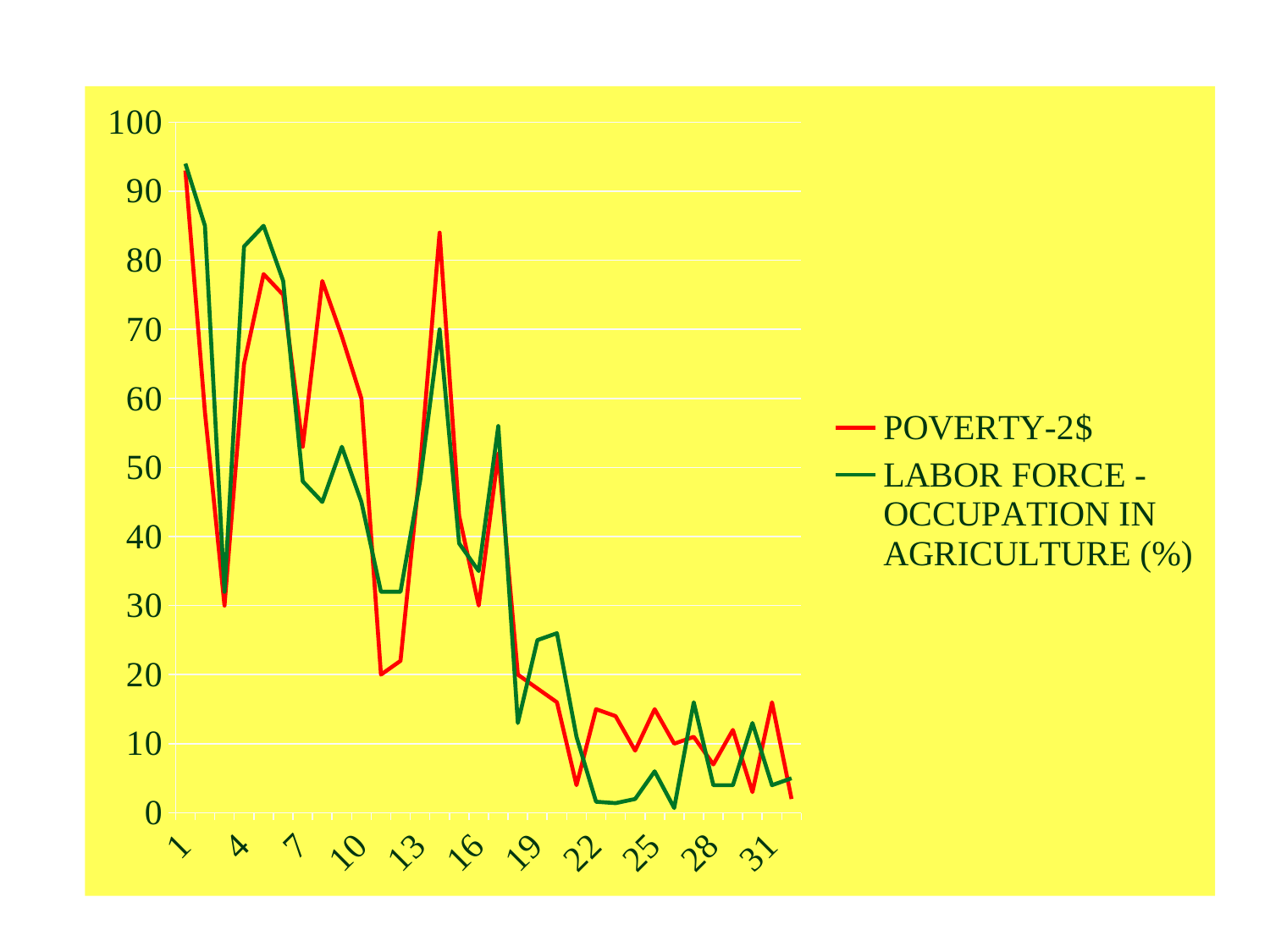
At category 14, which series has the larger value, POVERTY-2$ or LABOR FORCE - OCCUPATION IN AGRICULTURE (%)? POVERTY-2$ Is the value of POVERTY-2$ at category 14 greater or less than 80? greater Is the value of LABOR FORCE - OCCUPATION IN AGRICULTURE (%) at category 22 greater or less than 10? less At category 4, which series has the larger value, POVERTY-2$ or LABOR FORCE - OCCUPATION IN AGRICULTURE (%)? LABOR FORCE - OCCUPATION IN AGRICULTURE (%) How many series does the legend list? 2 What kind of chart is shown on the slide? line chart Overall, do the values of the POVERTY-2$ series rise or fall from left to right along the x axis? fall Which series is drawn in red? POVERTY-2$ Is the value of POVERTY-2$ at category 21 greater or less than 10? less At which category does the POVERTY-2$ series reach its highest value? 1 What is the name of the series drawn in green? LABOR FORCE - OCCUPATION IN AGRICULTURE (%)